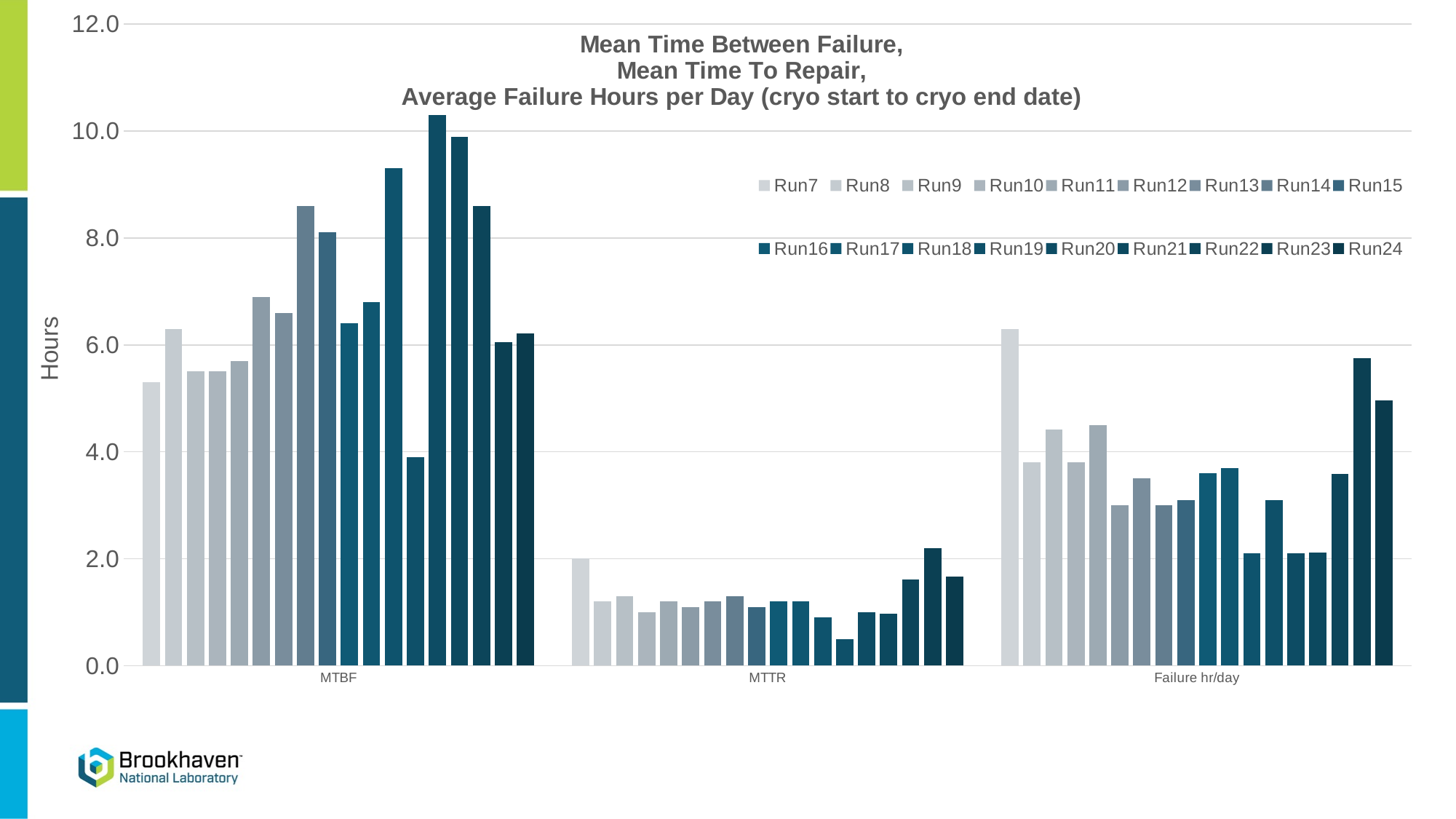
What is the label of the y axis? Hours Is the value for Run24 in the Failure hr/day category greater or less than 4.0? greater How many categories are shown along the x axis? 3 What are the three category labels on the x axis? MTBF, MTTR, Failure hr/day How many series does the legend list? 18 What kind of chart is shown on the slide? Bar chart Is the value for Run24 in the MTTR category greater or less than 2.0? less Which is larger: the Run7 bar for MTBF or the Run7 bar for MTTR? MTBF Is the tallest bar in the MTBF category greater or less than 8.0? greater Which category has the tallest bars overall? MTBF Which category has the lowest values overall? MTTR